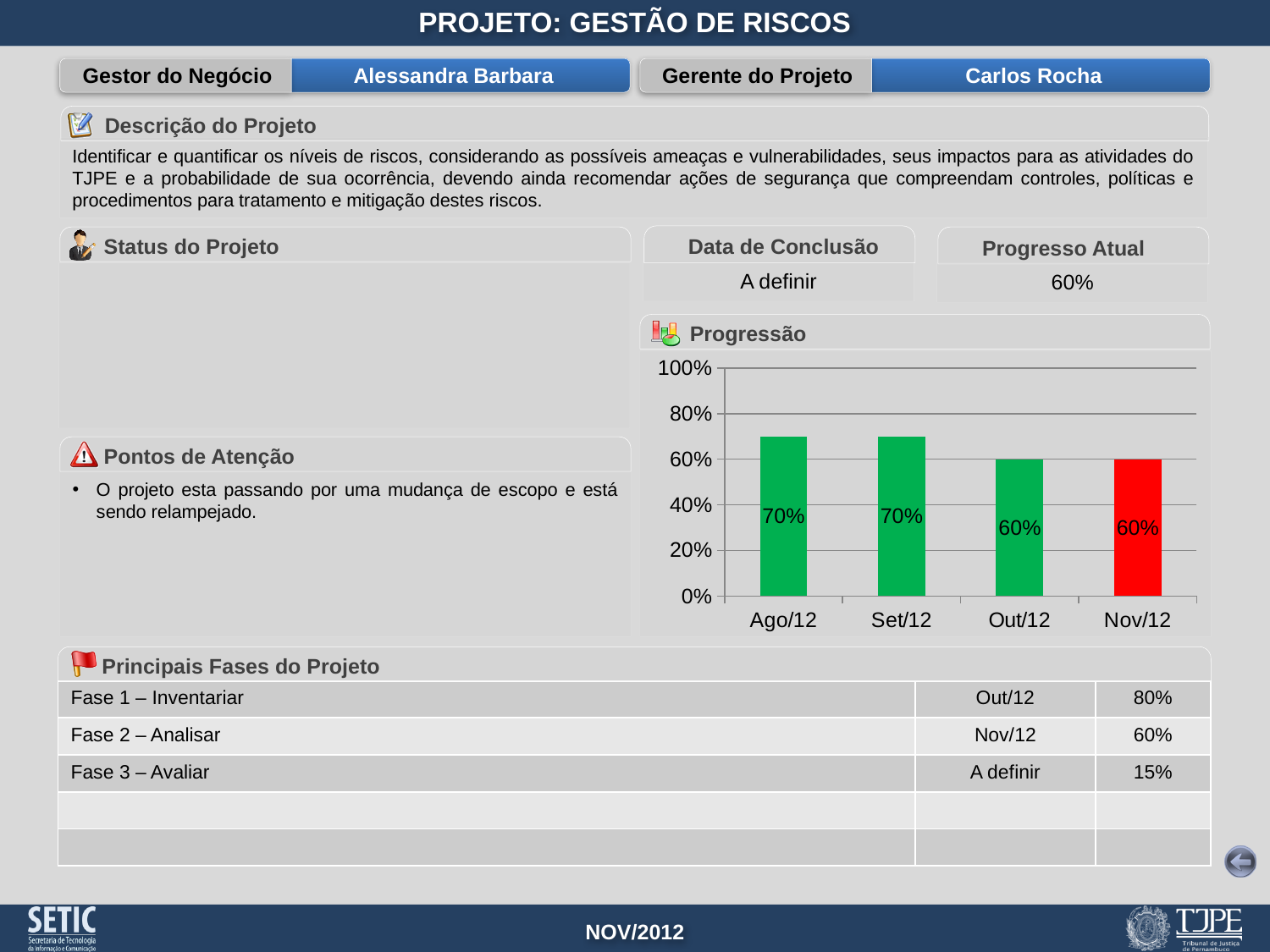
Do the values in the Progressão chart rise or fall from Ago/12 to Nov/12? fall How many categories are shown on the x axis of the Progressão chart? 4 What is the value for Nov/12 in the Progressão chart? 60% What is the title of the chart on the slide? Progressão What kind of chart is the Progressão chart? bar chart Is the value for Set/12 in the Progressão chart greater or less than 80%? less Which bar in the Progressão chart is coloured red? Nov/12 What is the difference between the values for Set/12 and Out/12 in the Progressão chart? 10% What is the highest value shown on the y axis of the Progressão chart? 100% Which is larger in the Progressão chart, the value for Ago/12 or the value for Nov/12? Ago/12 What is the value for Out/12 in the Progressão chart? 60% What is the value for Ago/12 in the Progressão chart? 70%